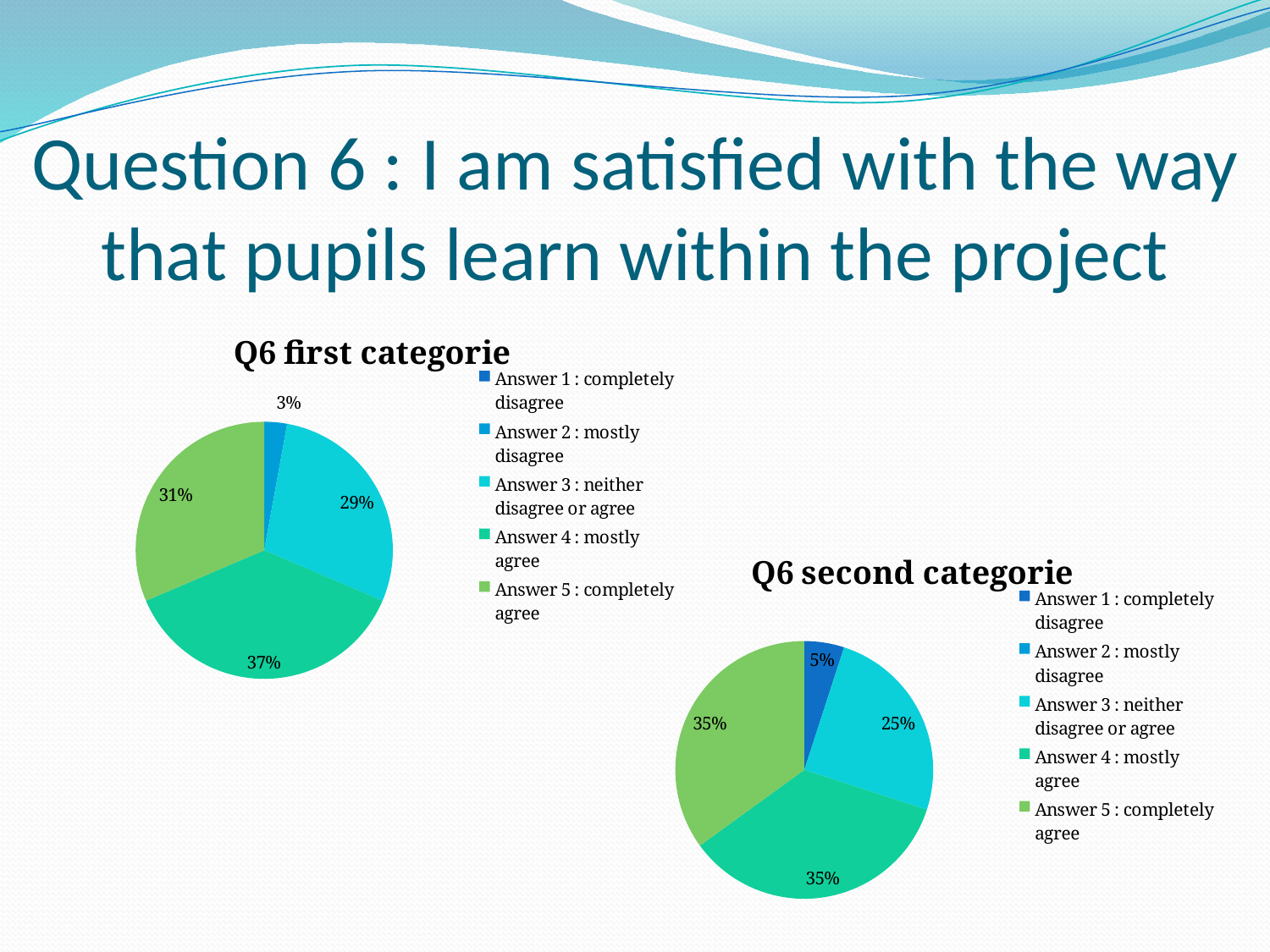
What type of chart is used for 'Q6 first categorie'? Pie chart In the 'Q6 first categorie' pie chart, what percentage is shown for 'Answer 4 : mostly agree'? 37% In the 'Q6 second categorie' pie chart, what is the percentage of the smallest slice? 5% In the 'Q6 first categorie' pie chart, what is the difference in percentage points between the 37% slice and the 29% slice? 8 percentage points In the 'Q6 first categorie' pie chart, which is larger: the share for 'Answer 5 : completely agree' or for 'Answer 3 : neither disagree or agree'? Answer 5 : completely agree In the 'Q6 first categorie' pie chart, what is the percentage of the smallest slice? 3% In the 'Q6 second categorie' pie chart, what percentage is shown for 'Answer 3 : neither disagree or agree'? 25% In the 'Q6 second categorie' pie chart, what is the difference in percentage points between the 'Answer 4 : mostly agree' slice and the 'Answer 3 : neither disagree or agree' slice? 10 percentage points How many entries does the legend of the 'Q6 second categorie' chart list? 5 In the 'Q6 second categorie' pie chart, what percentage is shown for 'Answer 5 : completely agree'? 35% In the 'Q6 first categorie' pie chart, which answer has the largest share? Answer 4 : mostly agree In the 'Q6 first categorie' pie chart, what percentage is shown for 'Answer 3 : neither disagree or agree'? 29%